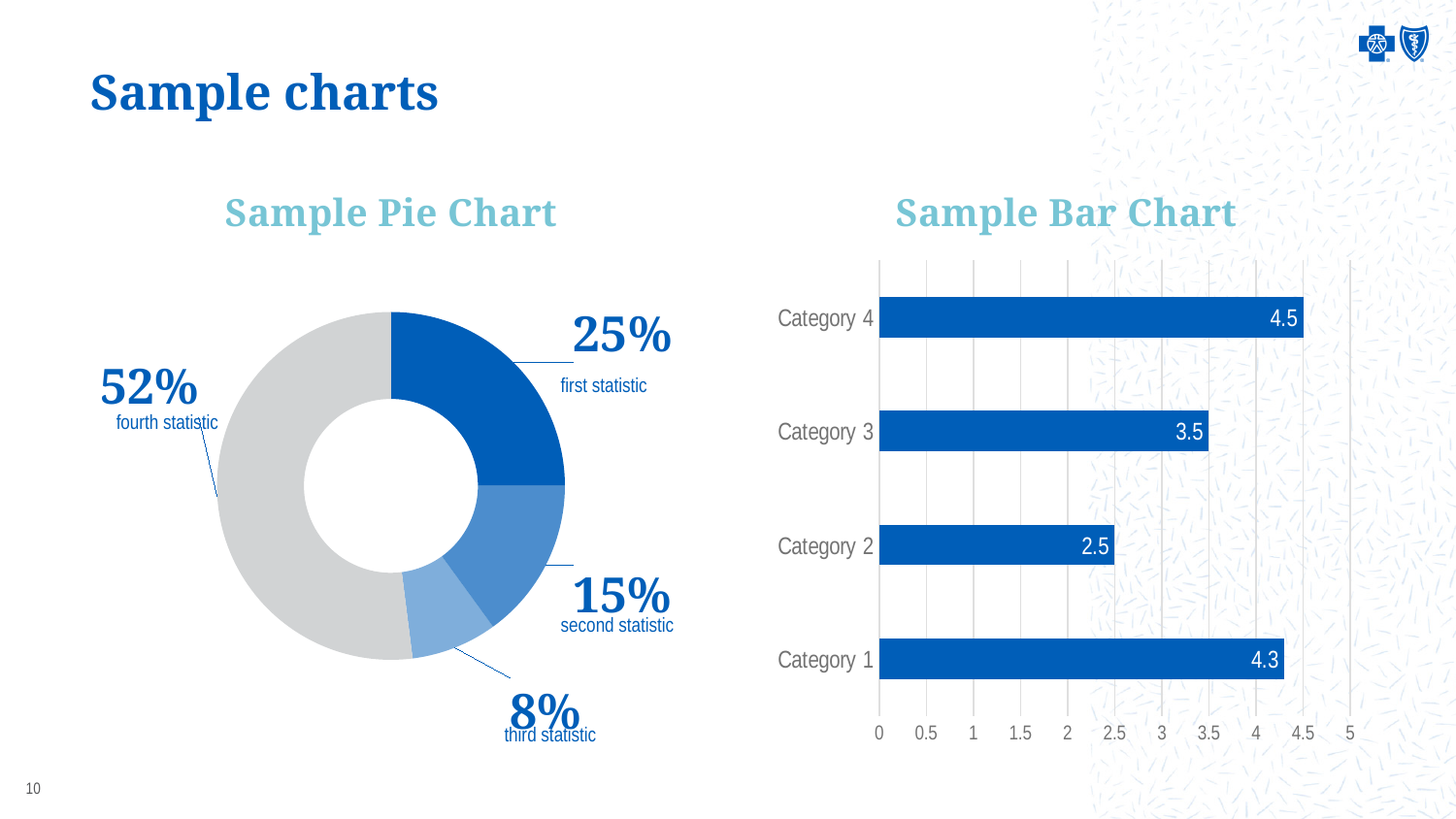
In the Sample Bar Chart, what is the value for Category 2? 2.5 In the Sample Bar Chart, how many categories are shown? 4 In the Sample Bar Chart, what is the difference between the values for Category 4 and Category 3? 1 What kind of chart is the Sample Bar Chart? Bar chart In the Sample Bar Chart, which category has the lowest value? Category 2 In the Sample Bar Chart, which category has the highest value? Category 4 In the Sample Pie Chart, which statistic has the largest share? fourth statistic In the Sample Pie Chart, what share does the third statistic have? 8% In the Sample Pie Chart, what share does the fourth statistic have? 52% In the Sample Bar Chart, what is the value for Category 4? 4.5 In the Sample Pie Chart, what is the difference between the shares of the first statistic and the second statistic? 10% In the Sample Bar Chart, which is larger, the value for Category 1 or the value for Category 3? Category 1